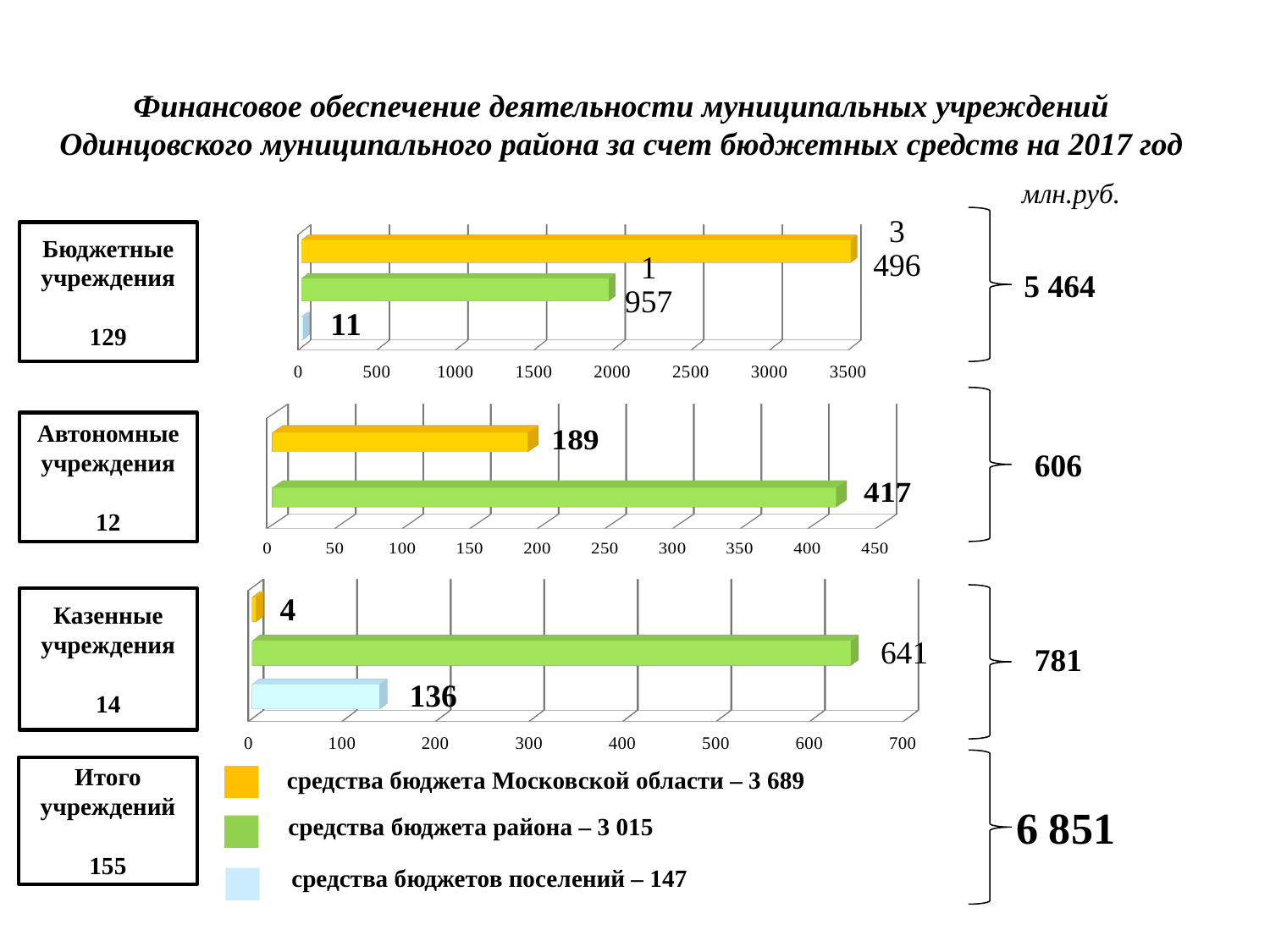
In the top chart (Бюджетные учреждения), what is the value of the green bar (средства бюджета района)? 1 957 In the bottom chart (Казенные учреждения), is the value for средства бюджетов поселений greater or less than 200? less What is the total shown for the top chart (Бюджетные учреждения)? 5 464 In the bottom chart (Казенные учреждения), which series has the lowest value? средства бюджета Московской области In the top chart (Бюджетные учреждения), what is the value for средства бюджетов поселений? 11 How many series does the legend at the bottom of the slide list? 3 How many bars are plotted in the middle chart (Автономные учреждения)? 2 In the middle chart (Автономные учреждения), what is the difference between the green bar (417) and the yellow bar (189)? 228 In the top chart (Бюджетные учреждения), what is the value of the yellow bar (средства бюджета Московской области)? 3 496 What type of chart is used for Бюджетные учреждения? bar chart In the bottom chart (Казенные учреждения), what is the value for средства бюджета района? 641 In the middle chart (Автономные учреждения), which series has the larger value: средства бюджета Московской области or средства бюджета района? средства бюджета района